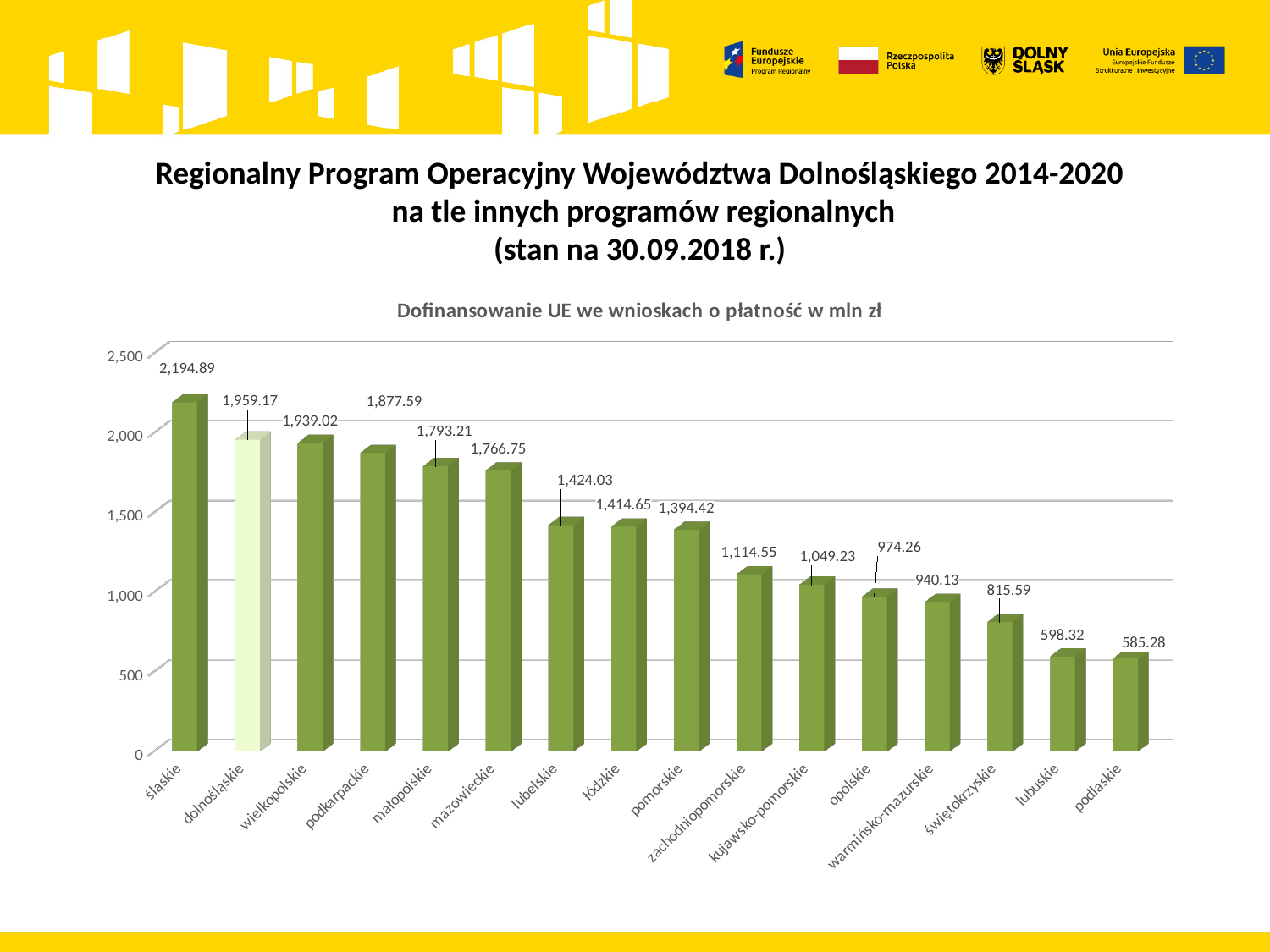
What is the value for świętokrzyskie? 815.59 Which is larger, the value for opolskie or the value for warmińsko-mazurskie? opolskie What is the title of the chart? Dofinansowanie UE we wnioskach o płatność w mln zł How many regions are shown on the chart? 16 Which region has the highest value? śląskie Is the value for zachodniopomorskie greater or less than 1,000? greater Which region has the lowest value? podlaskie What is the difference between the values for śląskie and dolnośląskie? 235.72 What kind of chart is shown on the slide? bar chart What is the value for dolnośląskie? 1,959.17 What is the value for lubelskie? 1,424.03 What is the difference between the values for dolnośląskie and wielkopolskie? 20.15